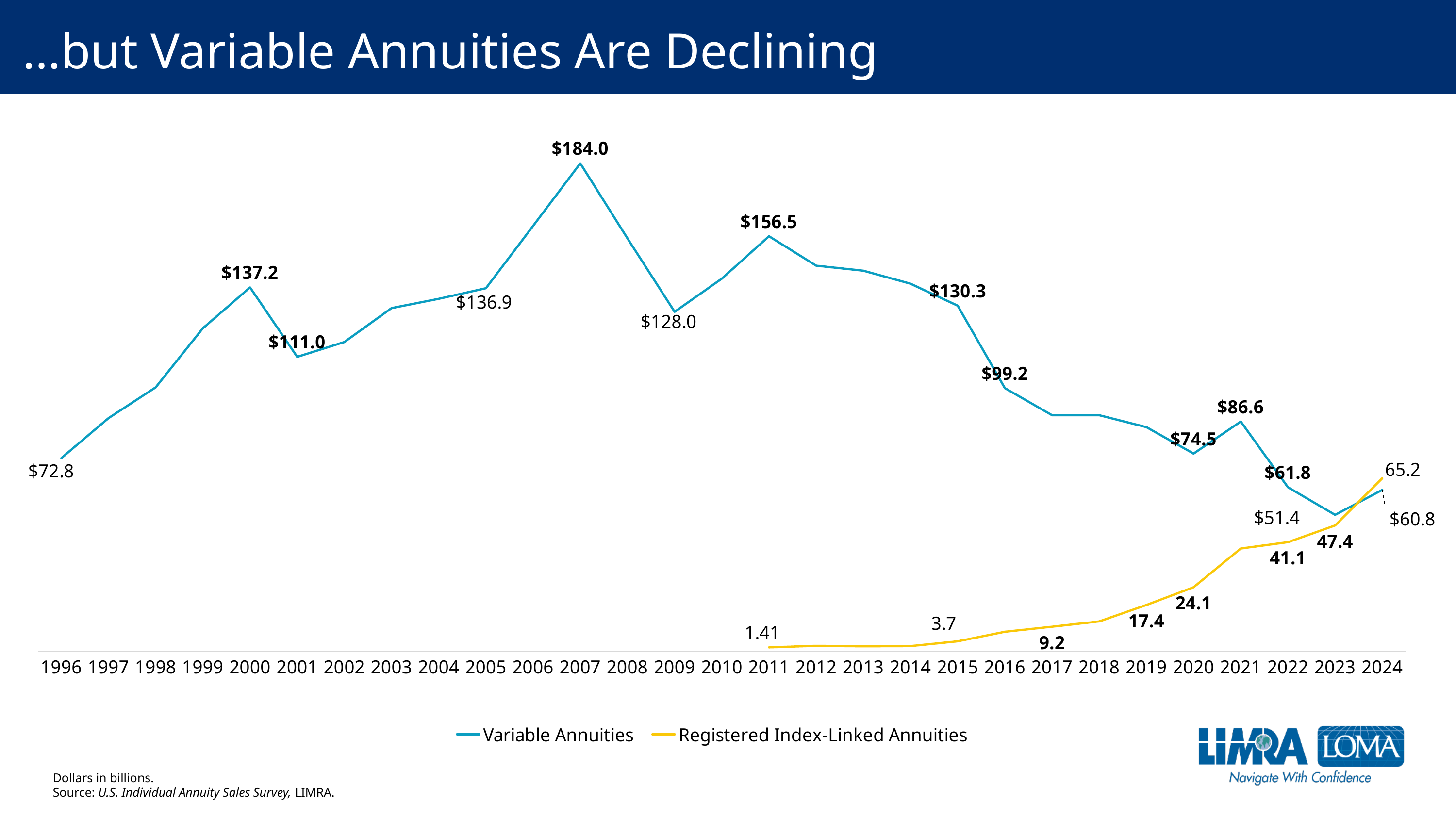
What kind of chart is shown on the slide? line chart In 2024, which series has the larger value, Variable Annuities or Registered Index-Linked Annuities? Registered Index-Linked Annuities Do Variable Annuities values generally rise or fall from 2011 to 2023? fall In which year did Variable Annuities reach their lowest value? 2023 What is the difference between the Variable Annuities value in 2000 and in 2001? $26.2 What is the difference between the Variable Annuities value in 2007 and in 2024? $123.2 How many years are shown on the x axis? 29 What was the value for Variable Annuities in 1996? $72.8 In which year did Variable Annuities reach their highest value? 2007 What was the value for Registered Index-Linked Annuities in 2024? 65.2 What was the value for Variable Annuities in 2007? $184.0 How many series does the legend list? 2